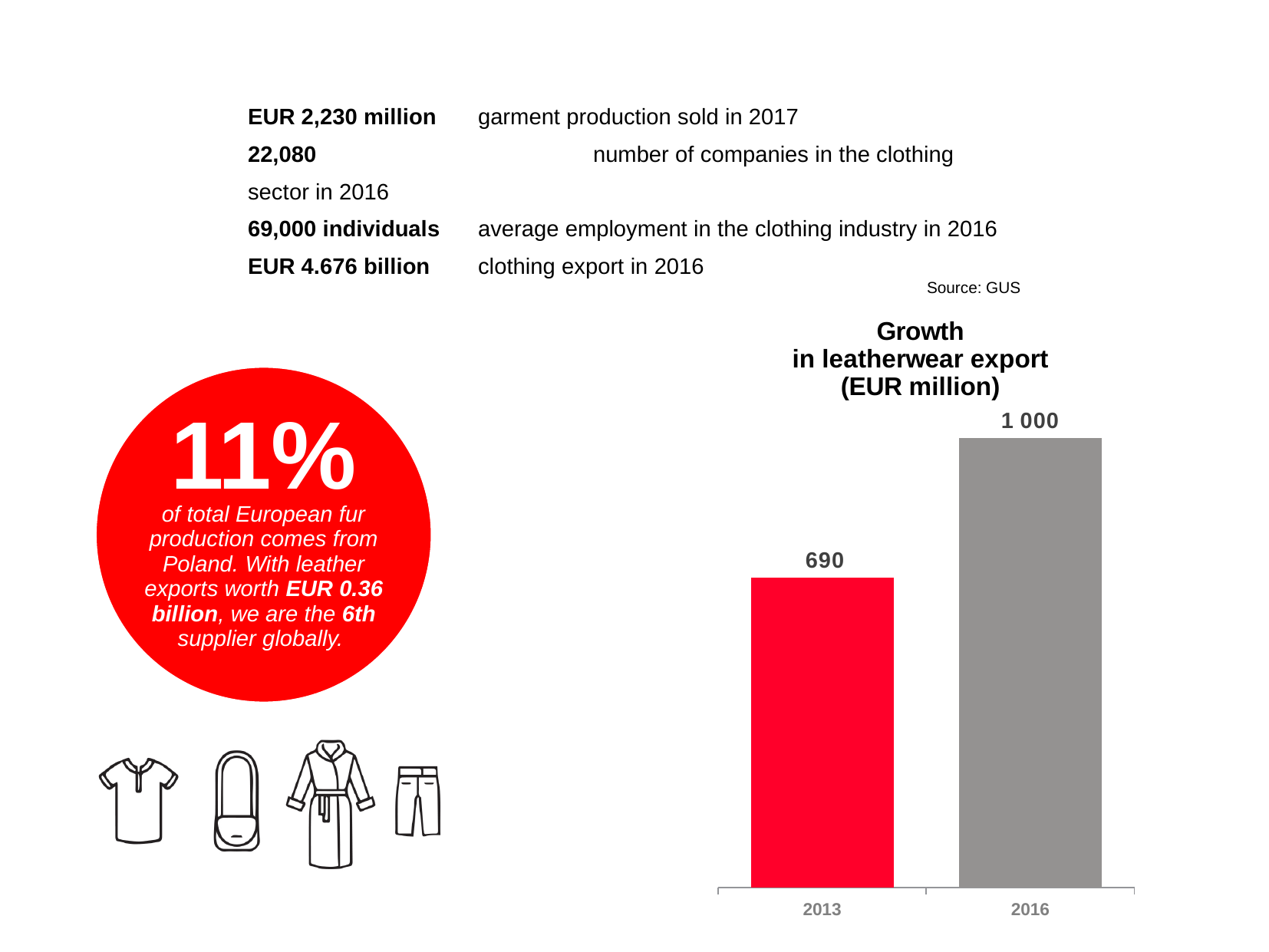
What is the value for 2013 in the leatherwear export chart? 690 Which is larger, the leatherwear export value for 2013 or for 2016? 2016 What kind of chart is used to show growth in leatherwear export? Bar chart What is the value for 2016 in the leatherwear export chart? 1 000 What colour is the bar for 2013 in the leatherwear export chart? Red How many years are shown in the leatherwear export chart? 2 Which year has the highest leatherwear export value? 2016 Which year has the lowest leatherwear export value? 2013 What is the difference between the 2016 and 2013 leatherwear export values? 310 What is the title of the chart on the slide? Growth in leatherwear export (EUR million) Do leatherwear export values rise or fall from 2013 to 2016? Rise